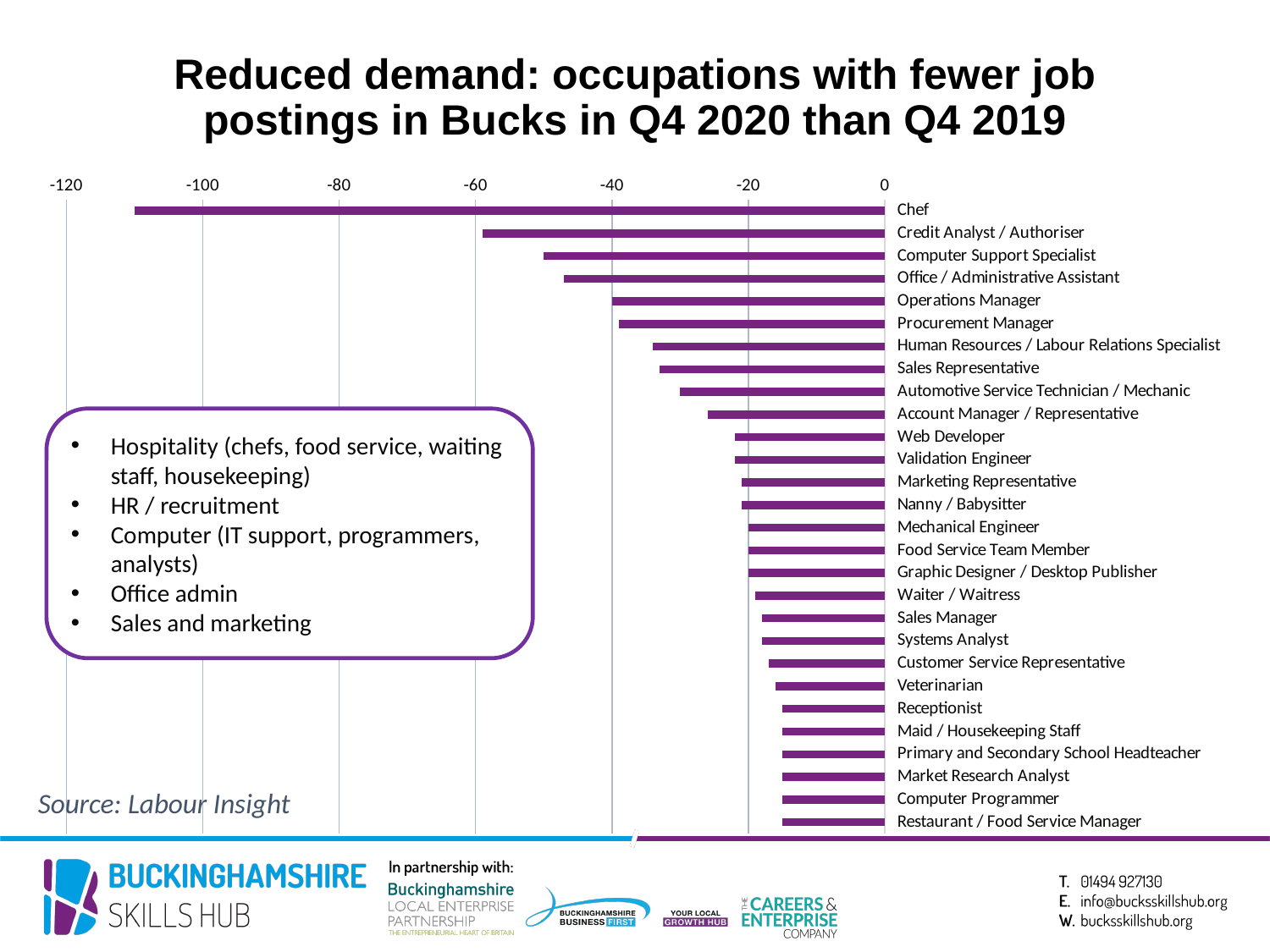
What kind of chart is shown on the slide? Bar chart Is the value for Chef greater or less than -100? less Which has the larger reduction in job postings, Chef or Credit Analyst / Authoriser? Chef Which occupation has the largest reduction in job postings (the longest bar)? Chef Which has the larger reduction in job postings, Computer Support Specialist or Sales Representative? Computer Support Specialist What is the title of the chart? Reduced demand: occupations with fewer job postings in Bucks in Q4 2020 than Q4 2019 Is the value for Account Manager / Representative greater or less than -20? less Is the value for Veterinarian greater or less than -20? greater Going down the chart from Chef to Restaurant / Food Service Manager, do the bars get longer or shorter? Shorter How many occupations are listed on the chart? 28